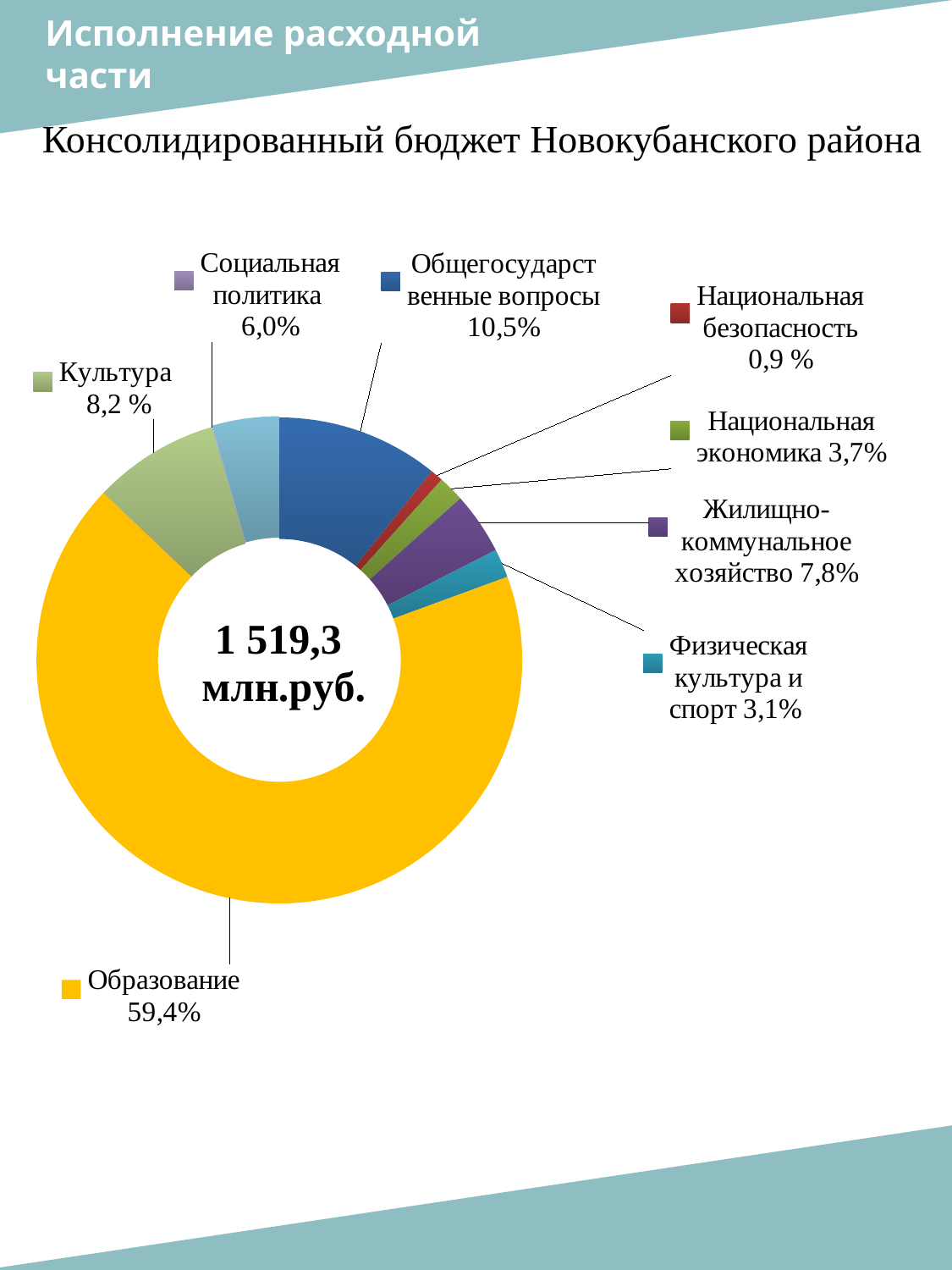
What total amount is printed in the centre of the chart? 1 519,3 млн.руб. What kind of chart is shown on the slide? Doughnut (pie) chart Which category has the smallest share of the chart? Национальная безопасность What percentage is shown for Общегосударственные вопросы? 10,5% What percentage is shown for Физическая культура и спорт? 3,1% Which category has the largest share of the chart? Образование What is the difference in percentage points between Культура and Социальная политика? 2,2 How many categories are shown in the chart? 8 What is the title of the chart on the slide? Консолидированный бюджет Новокубанского района Which has a larger share, Национальная экономика or Физическая культура и спорт? Национальная экономика What share of the doughnut chart does Образование account for? 59,4% What percentage is shown for Жилищно-коммунальное хозяйство? 7,8%